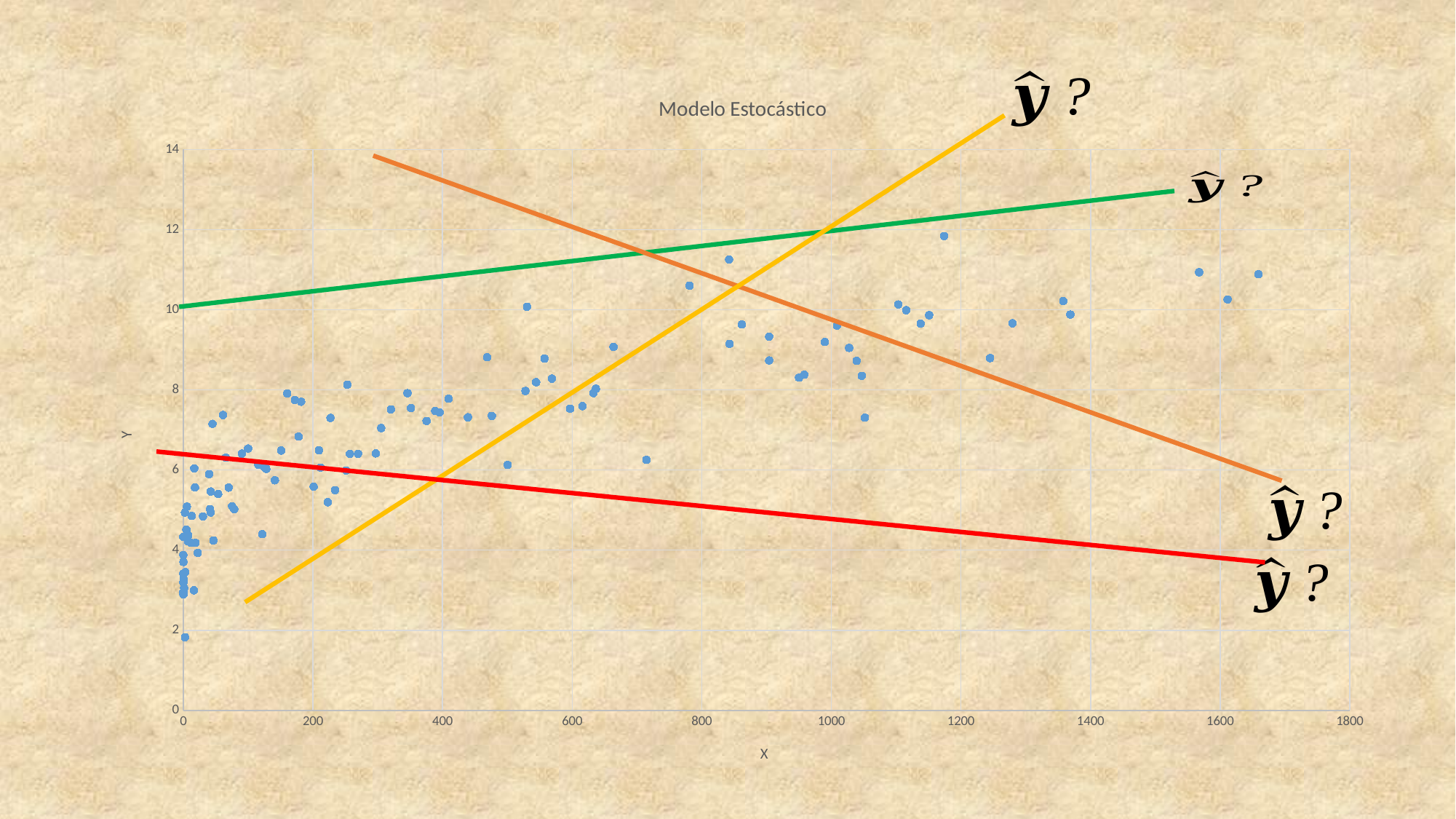
Is the lowest plotted Y value greater or less than 4? less What is the title of the chart? Modelo Estocástico Do the plotted Y values generally rise or fall as X increases? rise Is the largest plotted Y value greater or less than 14? less Is the largest plotted X value greater or less than 1800? less How many straight coloured lines are drawn over the scatter points? 4 What kind of chart is shown on the slide? scatter chart